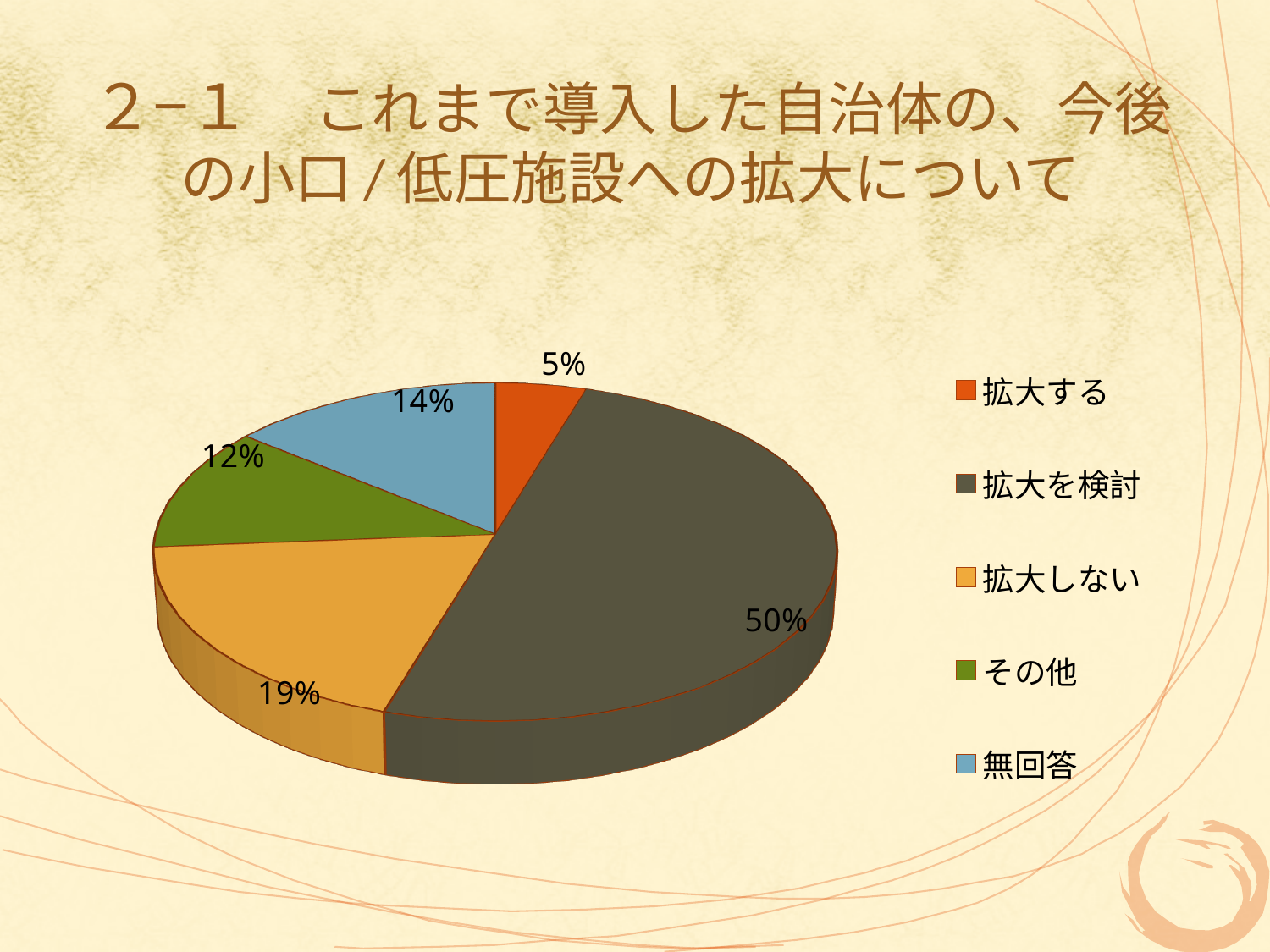
Which category has the largest share of the pie? 拡大を検討 What percentage of the pie is 拡大する? 5% What percentage of the pie is 拡大しない? 19% What is the difference in percentage points between 拡大を検討 and 拡大しない? 31 What percentage of the pie is 拡大を検討? 50% How many categories does the pie chart have? 5 Which category has the smallest share of the pie? 拡大する What colour is the slice for 拡大しない? orange What kind of chart is shown on the slide? pie chart Which is larger, the share for 無回答 or the share for その他? 無回答 What percentage of the pie is 無回答? 14% What percentage of the pie is その他? 12%